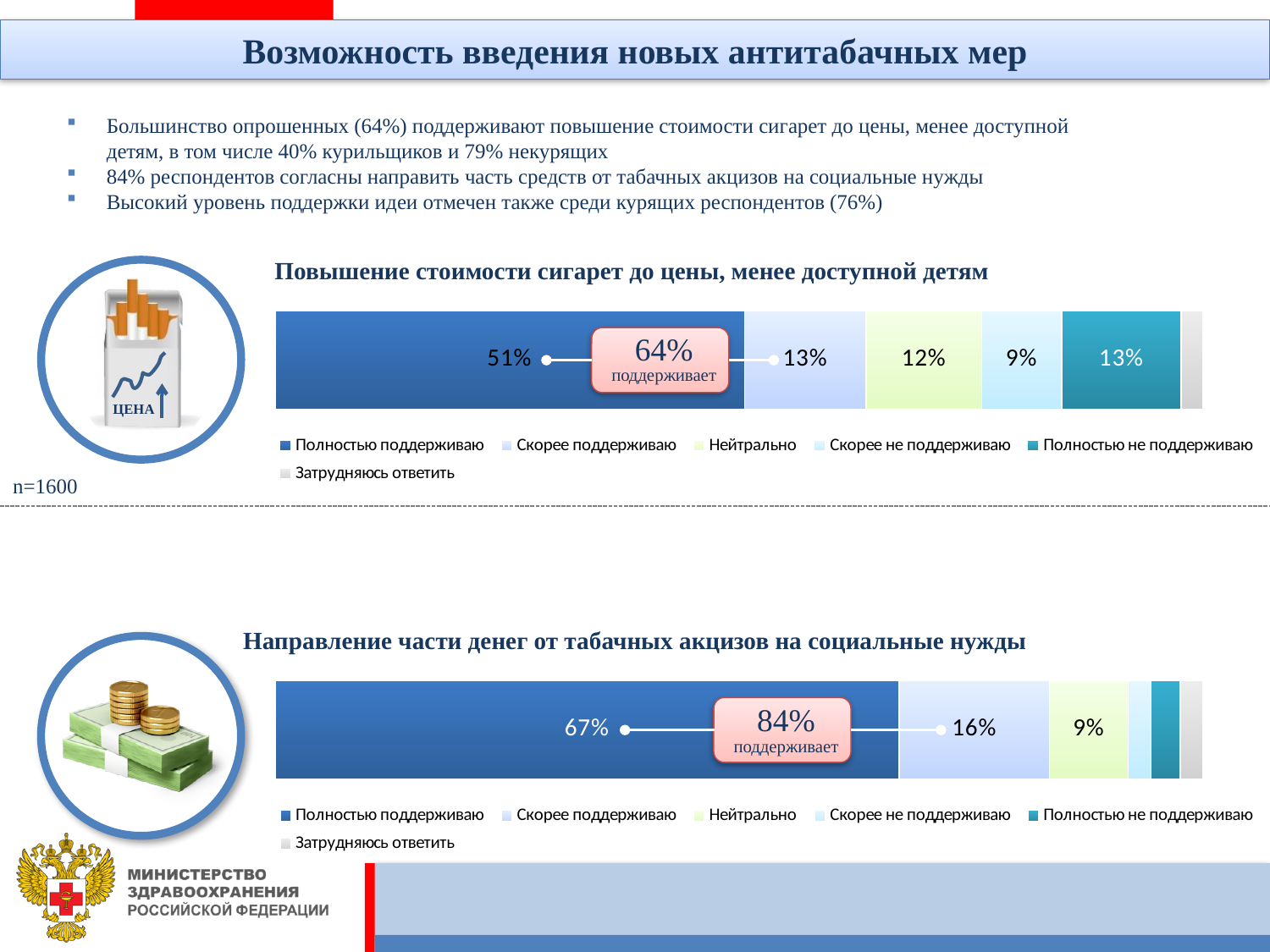
In the chart 'Направление части денег от табачных акцизов на социальные нужды', which is larger: 'Скорее поддерживаю' or 'Нейтрально'? Скорее поддерживаю In the chart 'Повышение стоимости сигарет до цены, менее доступной детям', what is the difference between 'Полностью поддерживаю' and 'Скорее поддерживаю'? 38% In the chart 'Повышение стоимости сигарет до цены, менее доступной детям', which segment is the largest? Полностью поддерживаю In the chart 'Направление части денег от табачных акцизов на социальные нужды', what is the value for 'Полностью поддерживаю'? 67% In the chart 'Направление части денег от табачных акцизов на социальные нужды', what total share of support is shown in the callout? 84% In the chart 'Повышение стоимости сигарет до цены, менее доступной детям', what is the value for 'Скорее не поддерживаю'? 9% In the chart 'Направление части денег от табачных акцизов на социальные нужды', what is the value for 'Скорее поддерживаю'? 16% In the chart 'Повышение стоимости сигарет до цены, менее доступной детям', how many series does the legend list? 6 In the chart 'Направление части денег от табачных акцизов на социальные нужды', what is the value for 'Нейтрально'? 9% What kind of chart is used in 'Направление части денег от табачных акцизов на социальные нужды'? Stacked bar chart In the chart 'Повышение стоимости сигарет до цены, менее доступной детям', what is the value for 'Нейтрально'? 12% In the chart 'Повышение стоимости сигарет до цены, менее доступной детям', what is the value for 'Полностью поддерживаю'? 51%